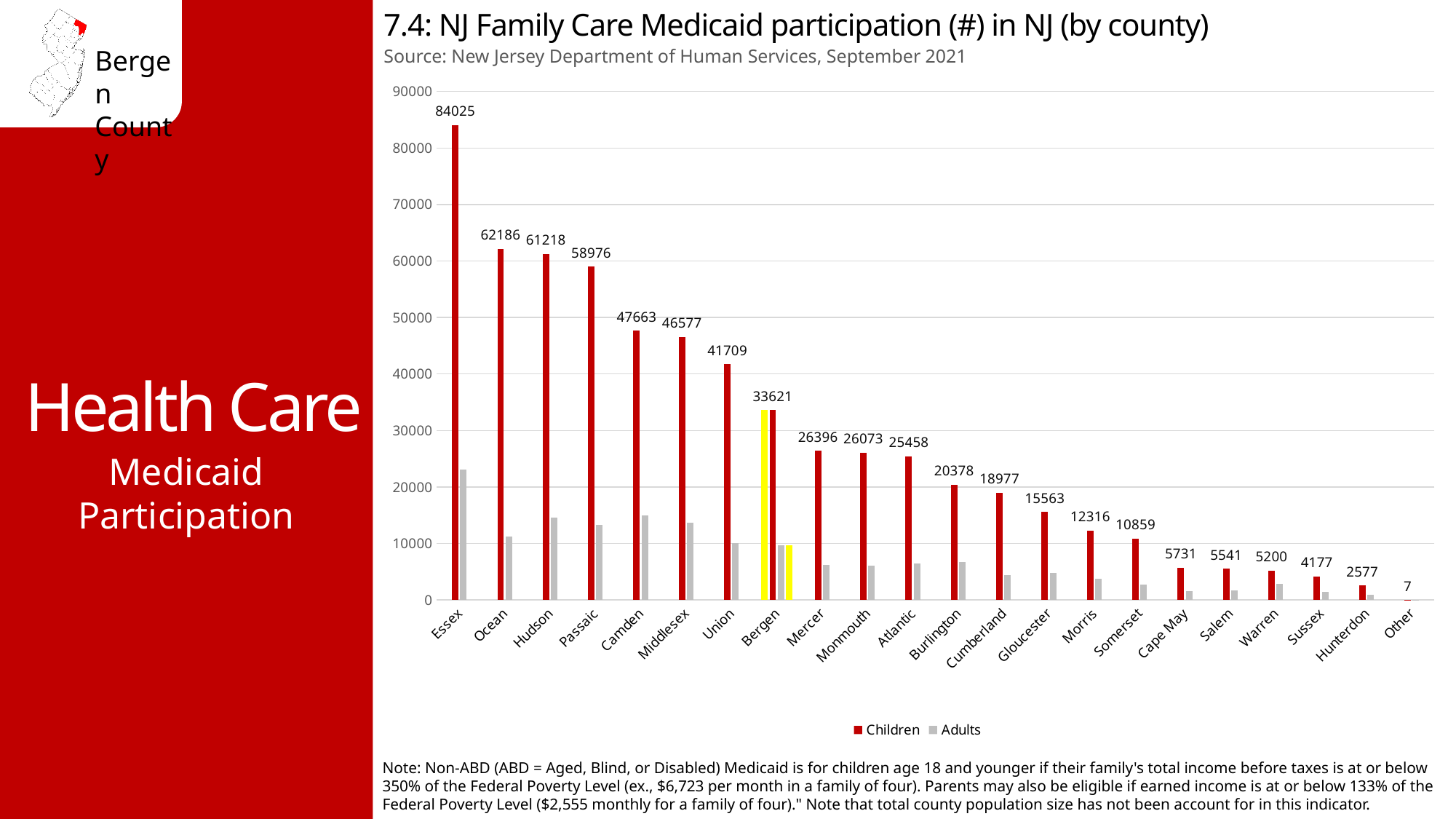
How many series does the legend list? 2 How many categories are shown on the x axis? 22 What is the difference between the Children values for Ocean and Hudson? 968 Which has a larger Children value, Camden or Union? Camden What kind of chart is shown? bar chart Which county has the highest Children value? Essex What is the Children value for Essex? 84025 What is the Children value for Bergen? 33621 What is the Children value for Cape May? 5731 Is the Adults value for Essex greater or less than 20000? greater Which category has the lowest Children value? Other